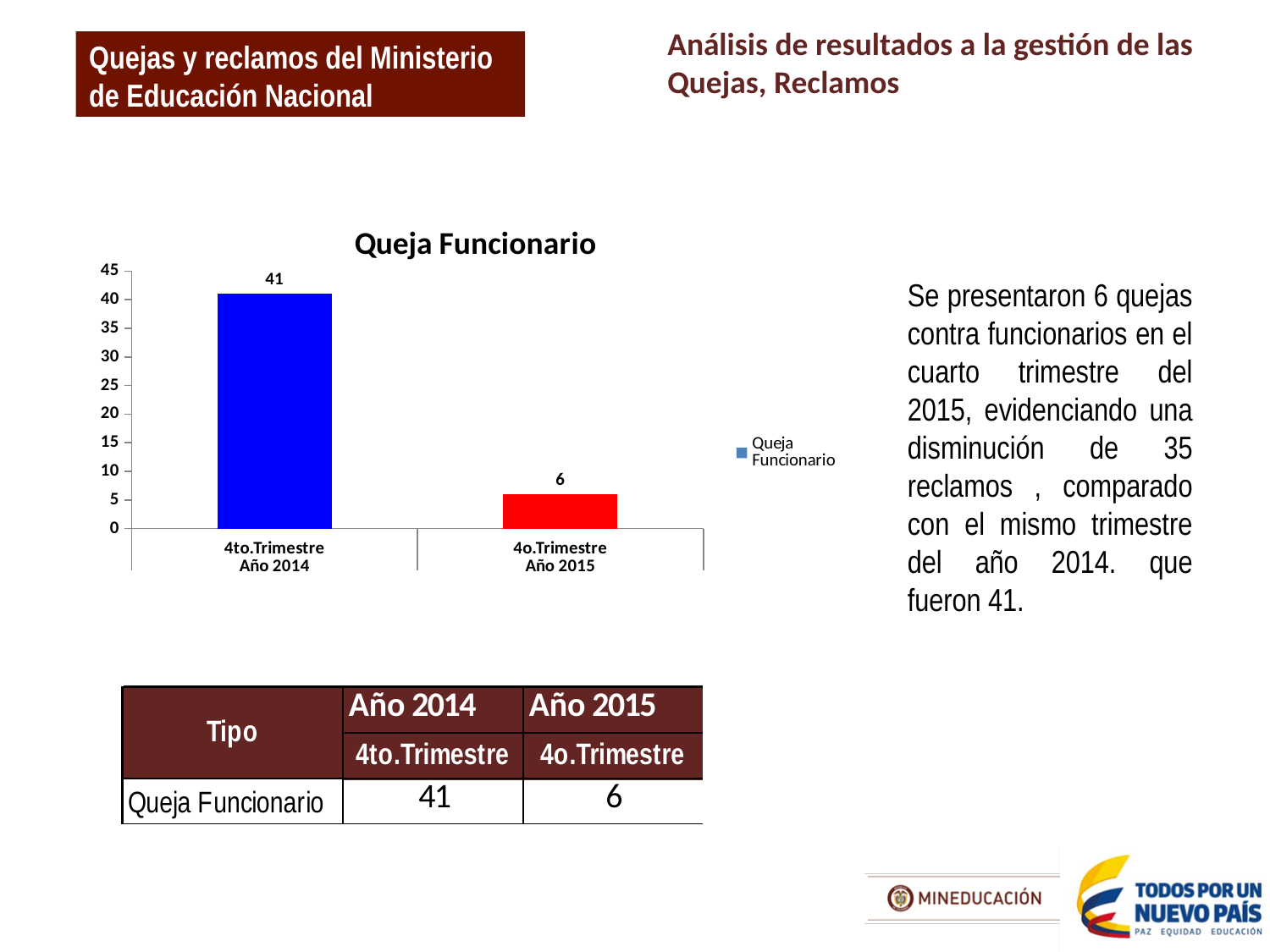
What is the value for 4o.Trimestre Año 2015 in the Queja Funcionario chart? 6 How many series does the legend of the Queja Funcionario chart list? 1 What is the title of the chart on the slide? Queja Funcionario Is the value for 4o.Trimestre Año 2015 greater or less than 10 in the Queja Funcionario chart? less What is the value for 4to.Trimestre Año 2014 in the Queja Funcionario chart? 41 How many categories are shown on the x axis of the Queja Funcionario chart? 2 Is the value for 4to.Trimestre Año 2014 greater or less than 40 in the Queja Funcionario chart? greater Which category has the lowest value in the Queja Funcionario chart? 4o.Trimestre Año 2015 What is the difference between the values for 4to.Trimestre Año 2014 and 4o.Trimestre Año 2015 in the Queja Funcionario chart? 35 Which is larger in the Queja Funcionario chart: the value for 4to.Trimestre Año 2014 or for 4o.Trimestre Año 2015? 4to.Trimestre Año 2014 What kind of chart is the Queja Funcionario chart? bar chart Which category has the highest value in the Queja Funcionario chart? 4to.Trimestre Año 2014